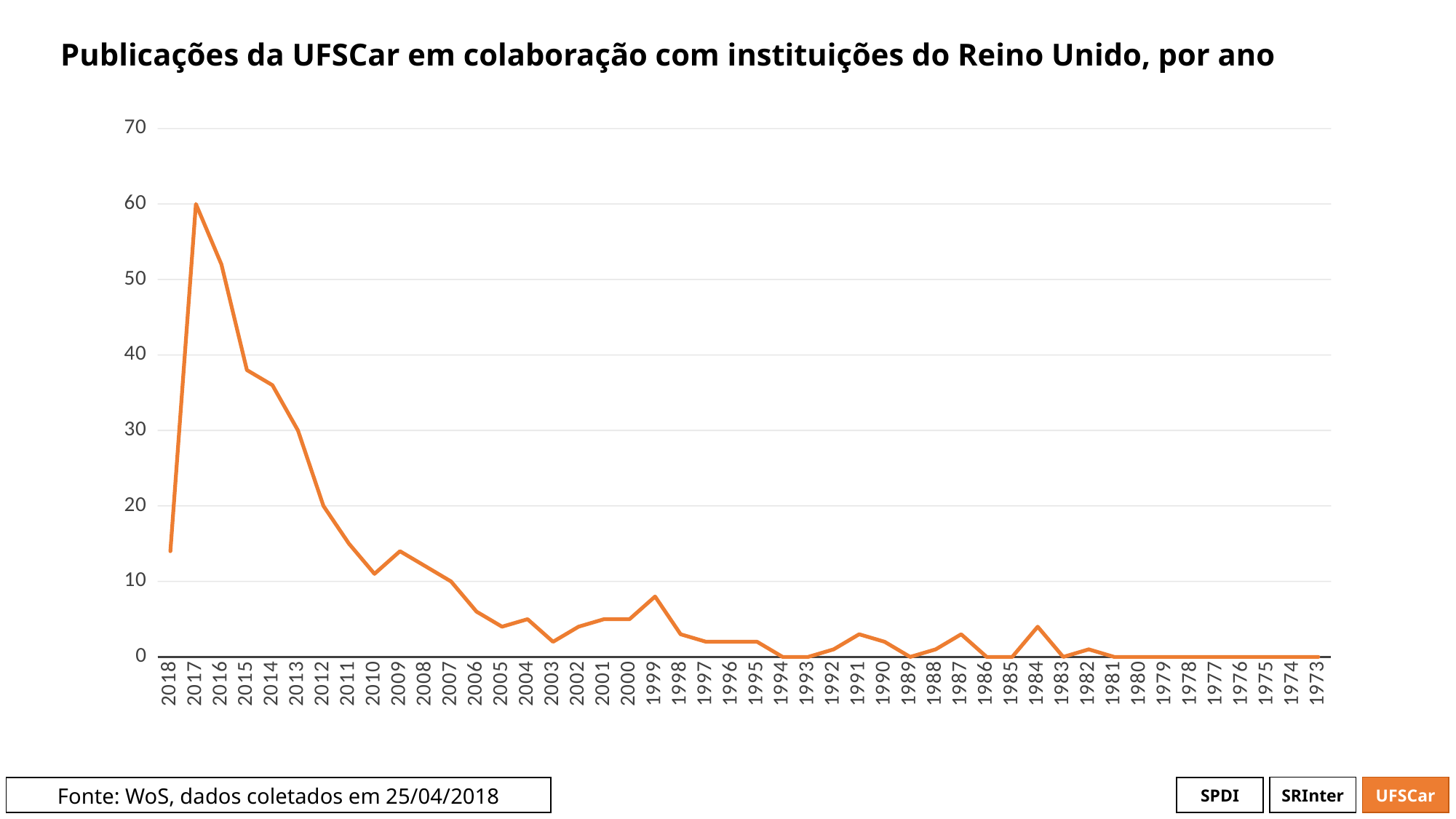
What is the title of the chart? Publicações da UFSCar em colaboração com instituições do Reino Unido, por ano What is the value for 2012? 20 Which year has the larger value, 2015 or 2011? 2015 How many years are shown on the x axis? 46 Which year has the highest number of publications? 2017 What kind of chart is shown on the slide? line chart What is the value for 1973? 0 What is the value for 2017? 60 Is the value for 2018 greater or less than 10? greater Is the value for 1999 greater or less than 10? less Is the value for 2016 greater or less than 50? greater